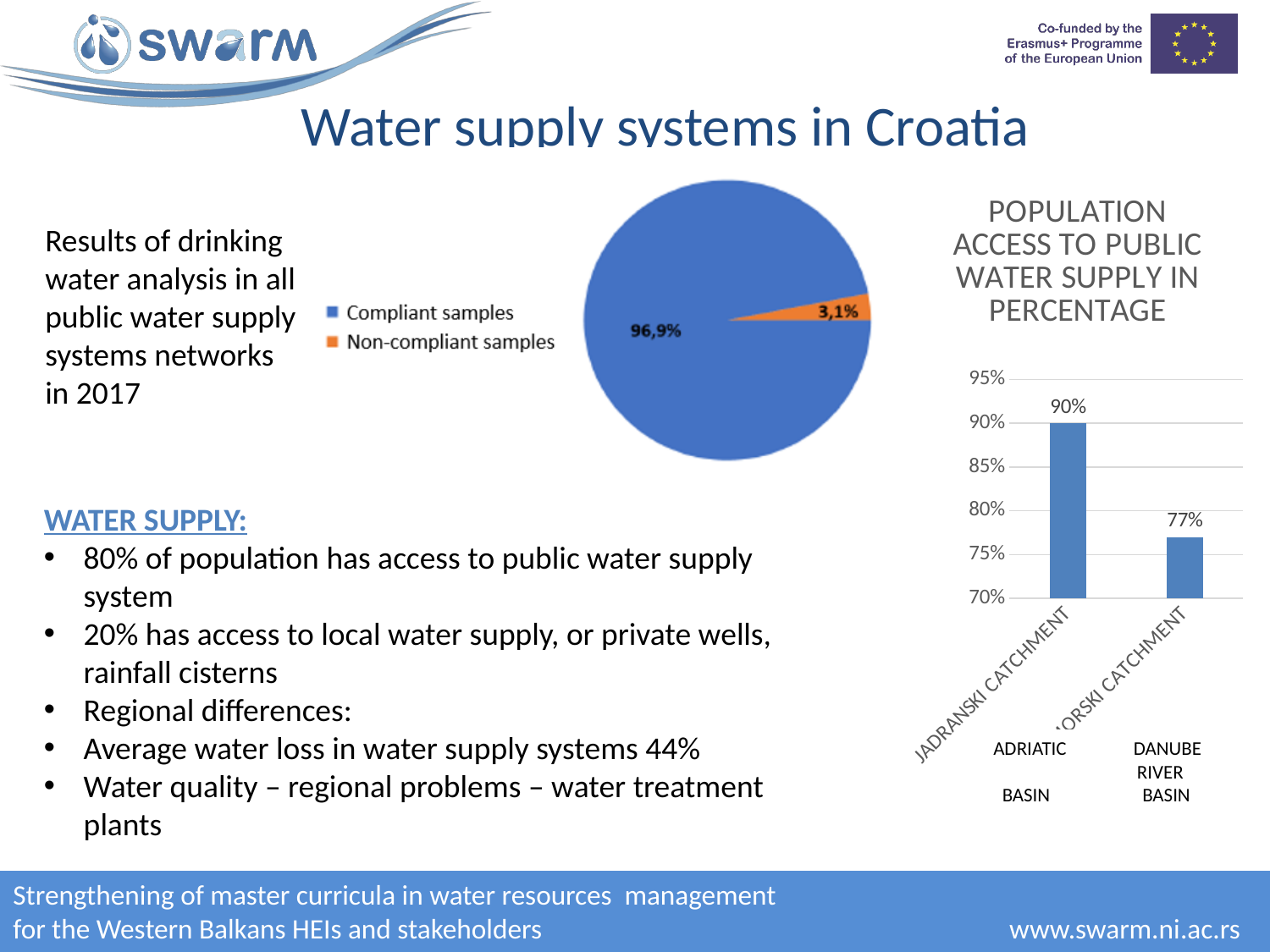
In the 'Population access to public water supply in percentage' chart, what is the difference between the Adriatic Basin and the Danube River Basin values? 13% In the pie chart, which category has the larger share? Compliant samples What kind of chart is the chart on the left showing compliant and non-compliant samples? Pie chart In the pie chart, which category has the smaller share? Non-compliant samples What kind of chart is the 'Population access to public water supply in percentage' chart? Bar chart In the 'Population access to public water supply in percentage' chart, what is the value for the Adriatic Basin (Jadranski catchment)? 90% In the pie chart, what percentage of samples were non-compliant? 3,1% How many entries does the legend of the pie chart list? 2 In the 'Population access to public water supply in percentage' chart, is the value for the Danube River Basin greater or less than 80%? less In the 'Population access to public water supply in percentage' chart, what is the value for the Danube River Basin? 77% In the 'Population access to public water supply in percentage' chart, which basin has the higher value? Adriatic Basin In the pie chart, what percentage of samples were compliant? 96,9%